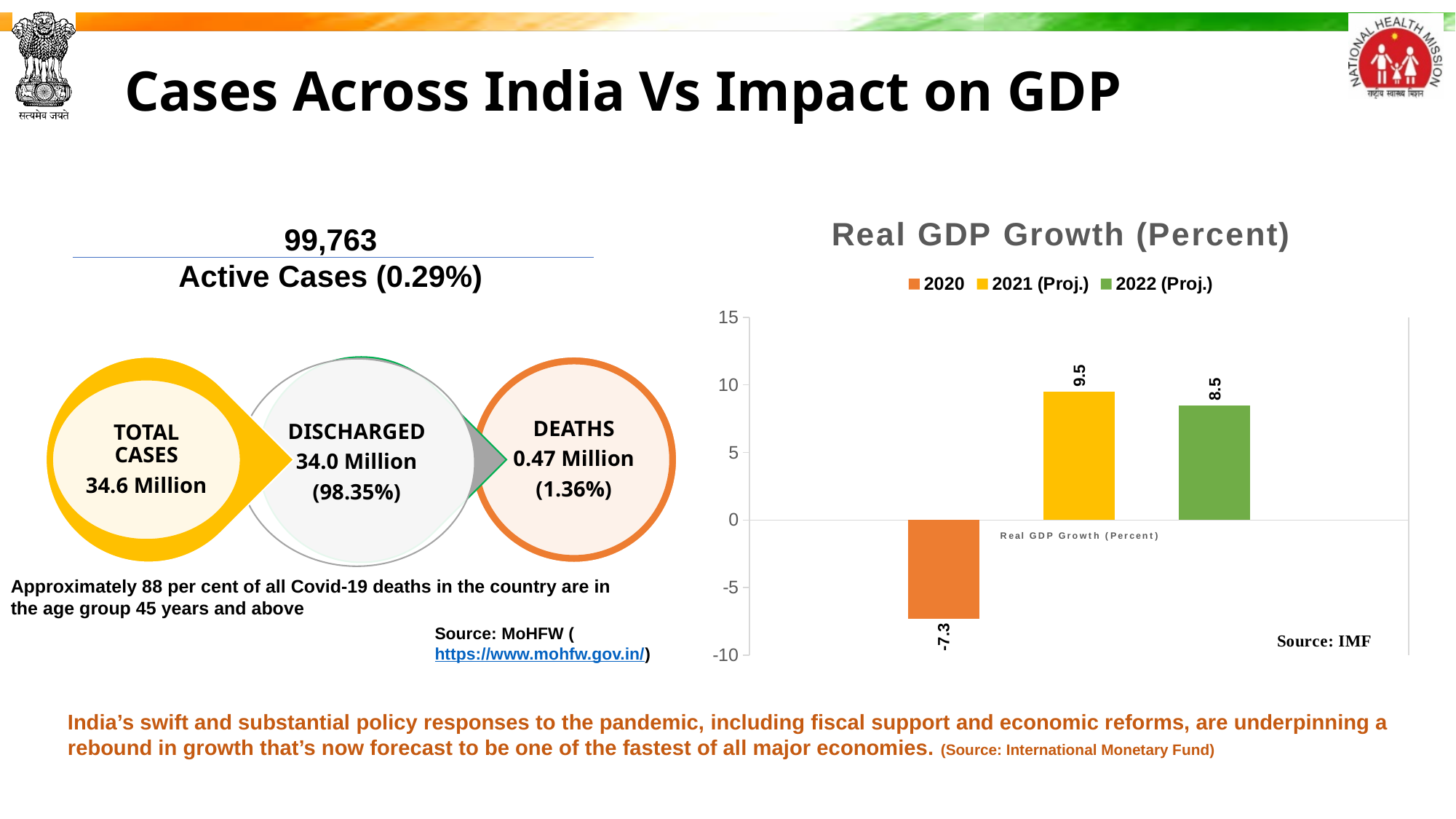
What is the title of the chart on the slide? Real GDP Growth (Percent) What is the Real GDP Growth value for 2021 (Proj.)? 9.5 Which series has the highest Real GDP Growth value? 2021 (Proj.) How many series does the legend of the Real GDP Growth chart list? 3 What is the difference between the Real GDP Growth values for 2021 (Proj.) and 2022 (Proj.)? 1.0 What is the Real GDP Growth value for 2022 (Proj.)? 8.5 What colour is the bar for 2020 in the Real GDP Growth chart? orange Which is larger, the Real GDP Growth value for 2021 (Proj.) or for 2022 (Proj.)? 2021 (Proj.) Which series has the lowest Real GDP Growth value? 2020 What is the Real GDP Growth value for 2020? -7.3 What type of chart is used to show Real GDP Growth (Percent)? bar chart Is the Real GDP Growth value for 2020 greater or less than -5? less